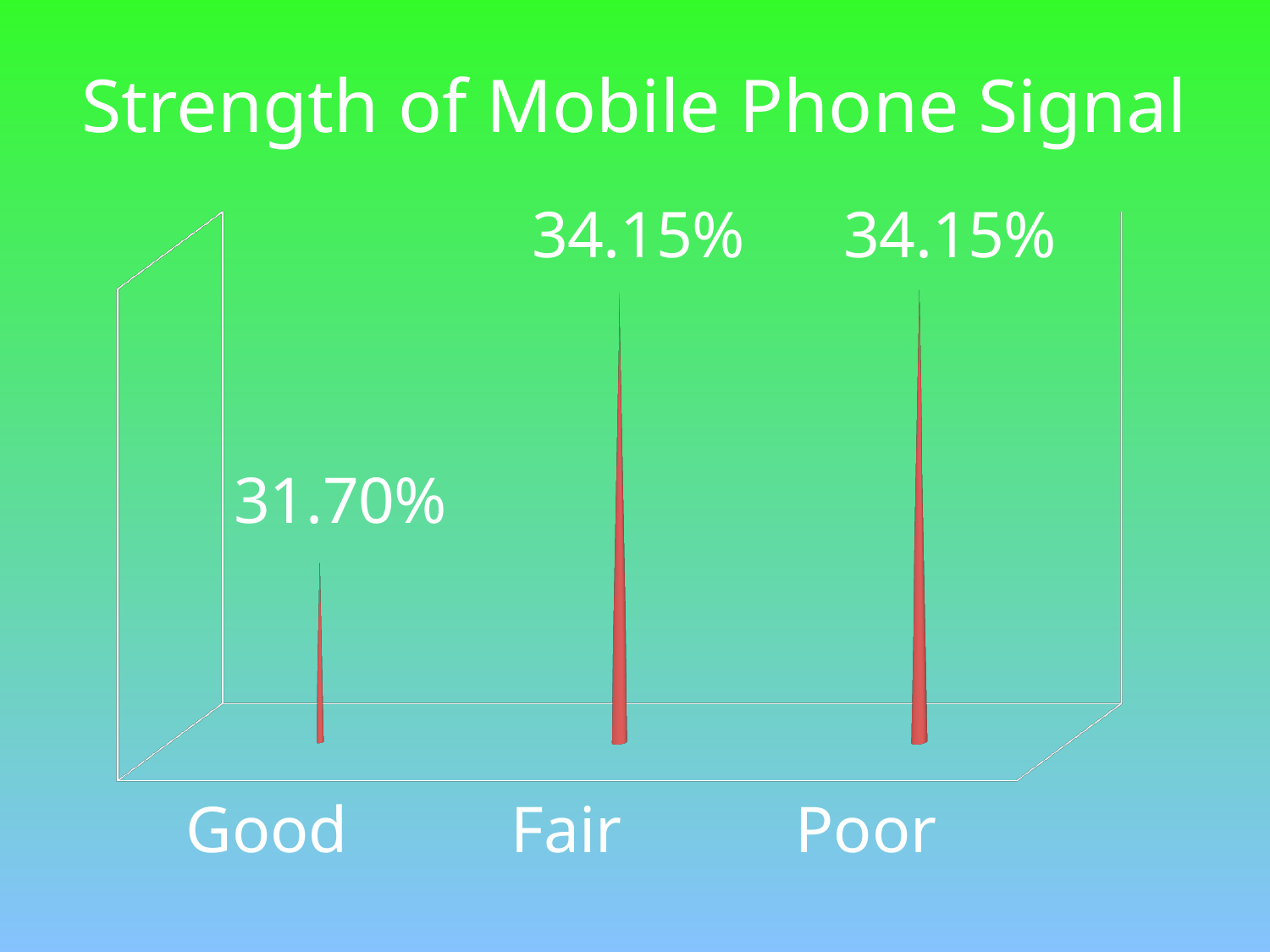
Which is larger, the value for Good or the value for Fair? Fair What is the value for Fair? 34.15% What is the difference between the values for Fair and Good? 2.45% What is the value for Good? 31.70% What is the value for Poor? 34.15% What is the title of the chart? Strength of Mobile Phone Signal What colour are the bars in the chart? Red What kind of chart is shown on the slide? Bar chart What is the total of the three values shown? 100.00% Which category has the lowest value? Good Are the values for Fair and Poor equal? Yes How many categories are shown on the x axis? 3